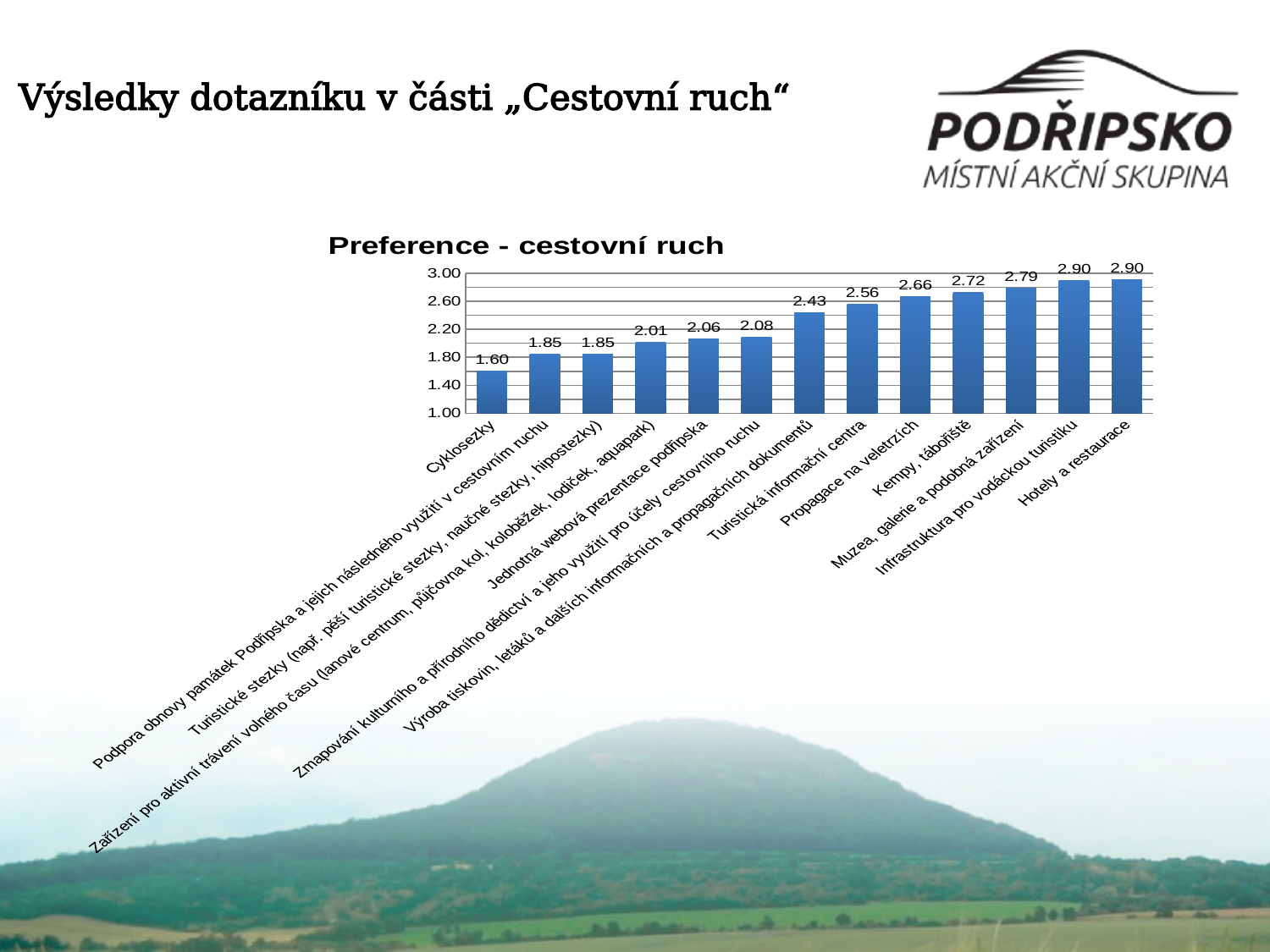
What is the value for Cyklosezky? 1.60 What kind of chart is shown? Bar chart What is the value for Turistická informační centra? 2.56 How many categories are shown in the chart? 13 What is the value for Kempy, tábořiště? 2.72 Do the values rise or fall from left to right along the x axis? Rise Which is larger, the value for Muzea, galerie a podobná zařízení or the value for Kempy, tábořiště? Muzea, galerie a podobná zařízení Which category has the lowest value? Cyklosezky What is the title of the chart? Preference - cestovní ruch What is the difference between the values for Propagace na veletrzích and Cyklosezky? 1.06 What is the highest value shown in the chart? 2.90 What is the value for Hotely a restaurace? 2.90